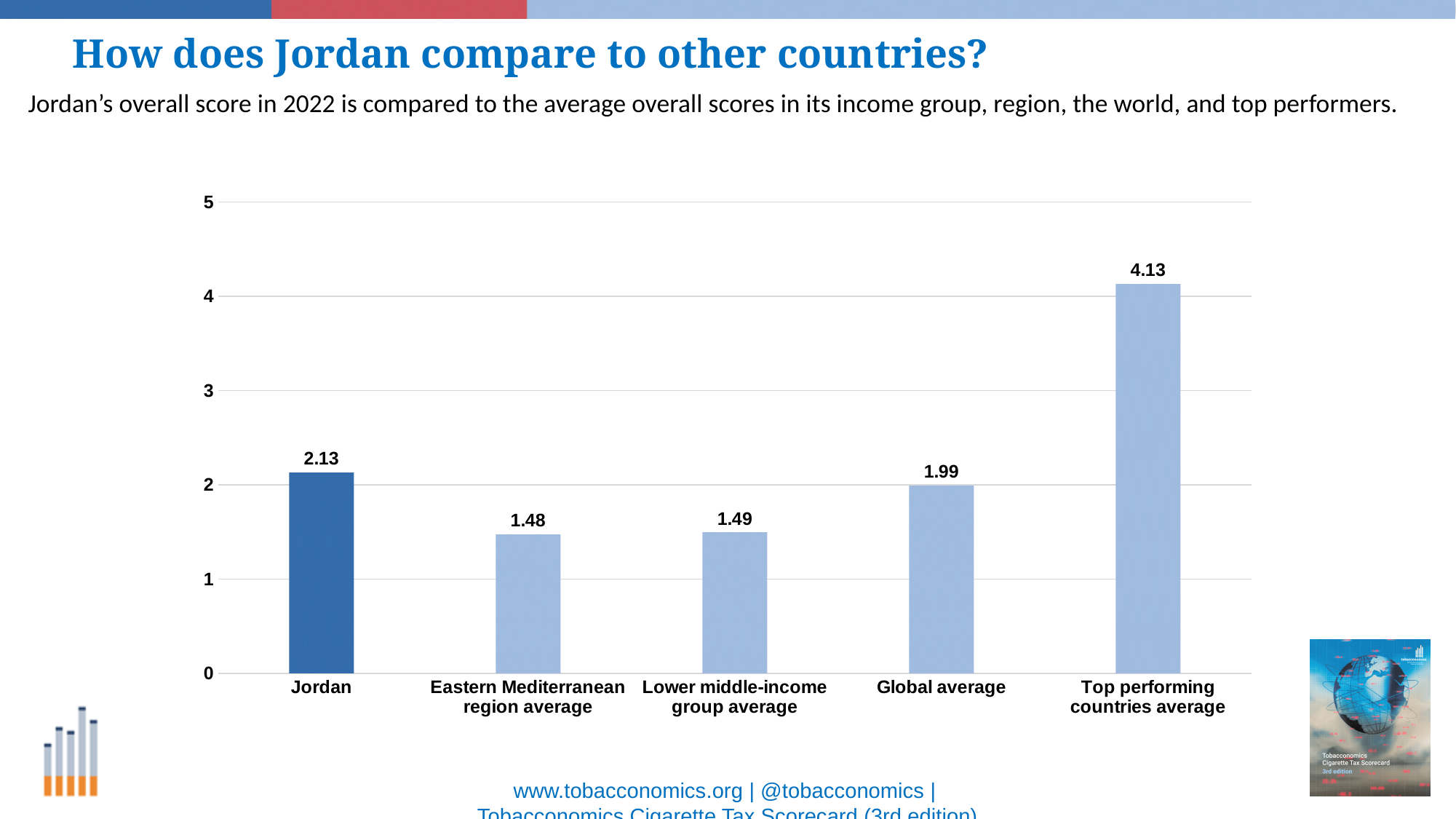
What is the difference between Jordan's score and the Global average? 0.14 Is the value for the Lower middle-income group average greater or less than 2? less What is the value for the Global average? 1.99 Which is larger, Jordan's score or the Global average? Jordan What is the overall score for Jordan? 2.13 What is the value for the Eastern Mediterranean region average? 1.48 Which category has the highest value? Top performing countries average How many categories are shown in the chart? 5 Which category has the lowest value? Eastern Mediterranean region average What is the difference between the Top performing countries average and Jordan's score? 2.00 What is the value for the Top performing countries average? 4.13 What kind of chart is shown on the slide? bar chart